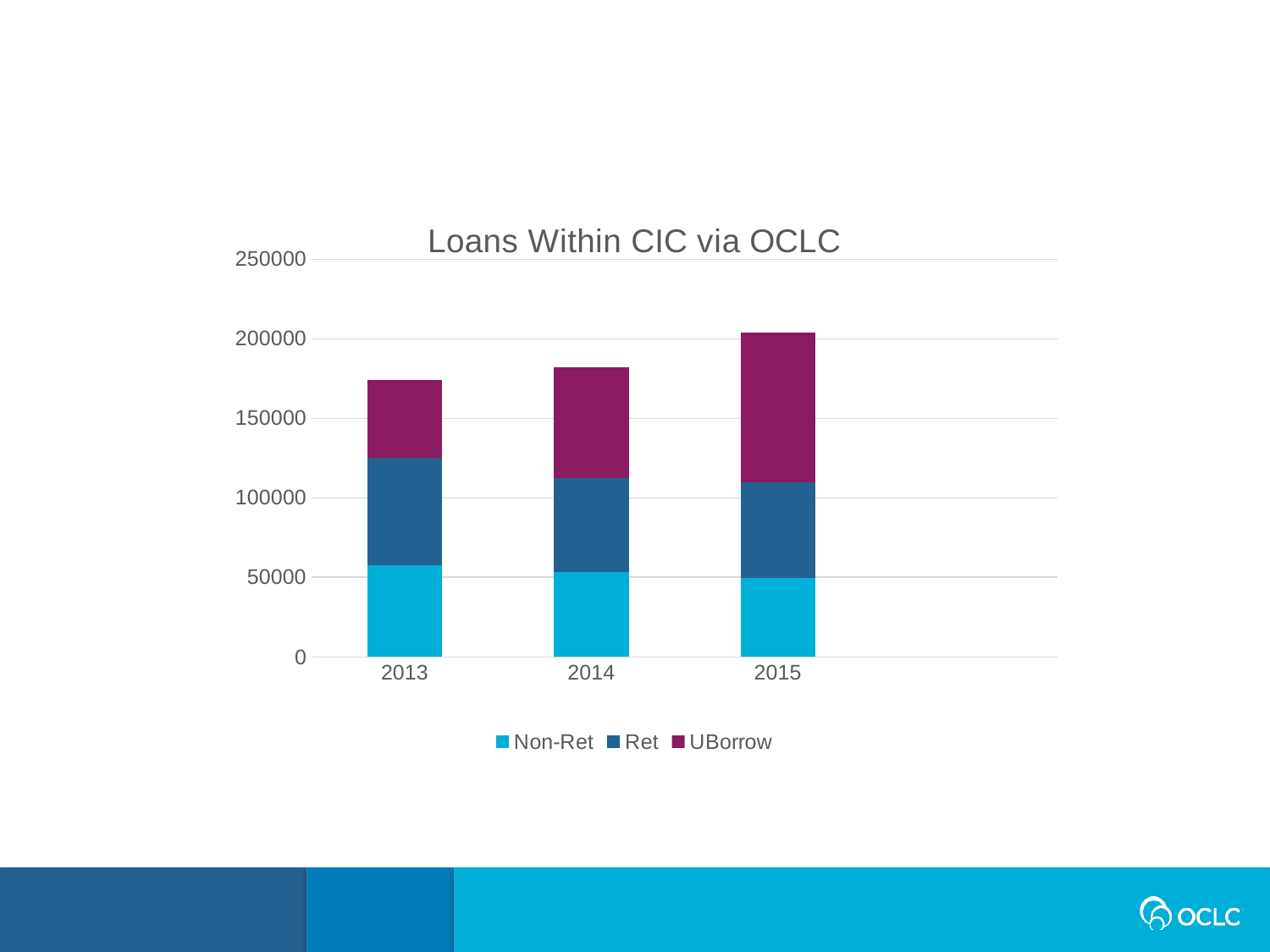
Is the total stacked bar for 2013 greater or less than 200000? less Is the Non-Ret value for 2013 greater or less than 50000? greater What is the title of the chart? Loans Within CIC via OCLC Do the total loans rise or fall from 2013 to 2015? rise Which year has the shortest stacked bar? 2013 How many years are shown on the x axis? 3 How many series does the legend list? 3 Which year has the tallest stacked bar? 2015 Is the total stacked bar for 2015 greater or less than 200000? greater Which series is shown in the light blue colour at the bottom of each bar? Non-Ret Is the UBorrow segment larger in 2013 or in 2015? 2015 What kind of chart is shown on the slide? stacked bar chart